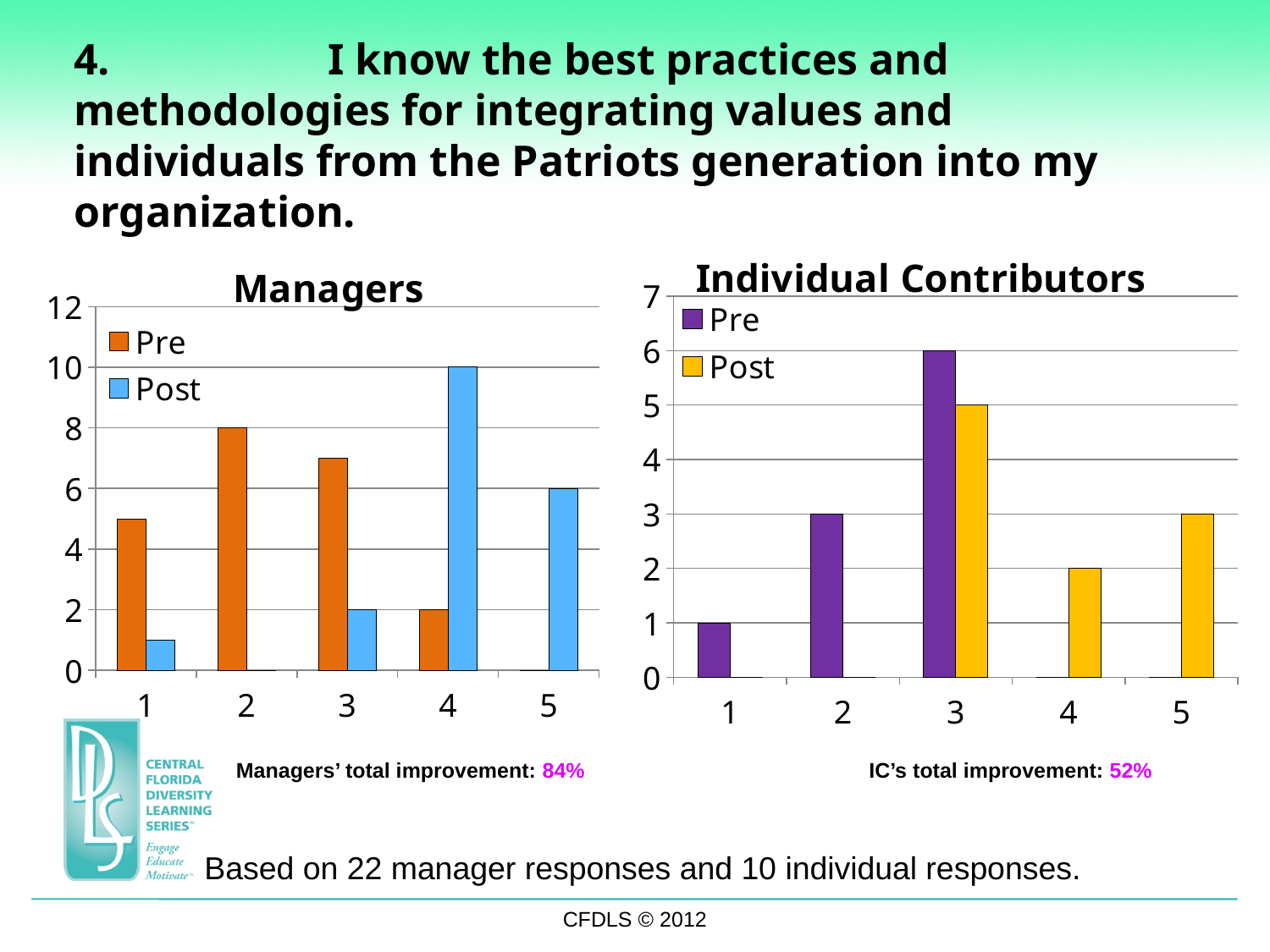
What kind of chart is the Managers chart? bar chart In the Managers chart, is the Pre value for category 3 greater or less than 6? greater How many series does the legend of the Individual Contributors chart list? 2 In the Managers chart, is the Pre value for category 1 greater or less than 4? greater In the Individual Contributors chart, which has the larger Post value, category 4 or category 5? 5 In the Individual Contributors chart, what is the difference between the Pre and Post values for category 3? 1 In the Managers chart, what is the Post value for category 4? 10 In the Individual Contributors chart, what is the Post value for category 3? 5 In the Individual Contributors chart, what is the Pre value for category 3? 6 In the Individual Contributors chart, which category has the highest Pre value? 3 In the Managers chart, which category has the highest Post value? 4 In the Managers chart, what is the Pre value for category 2? 8